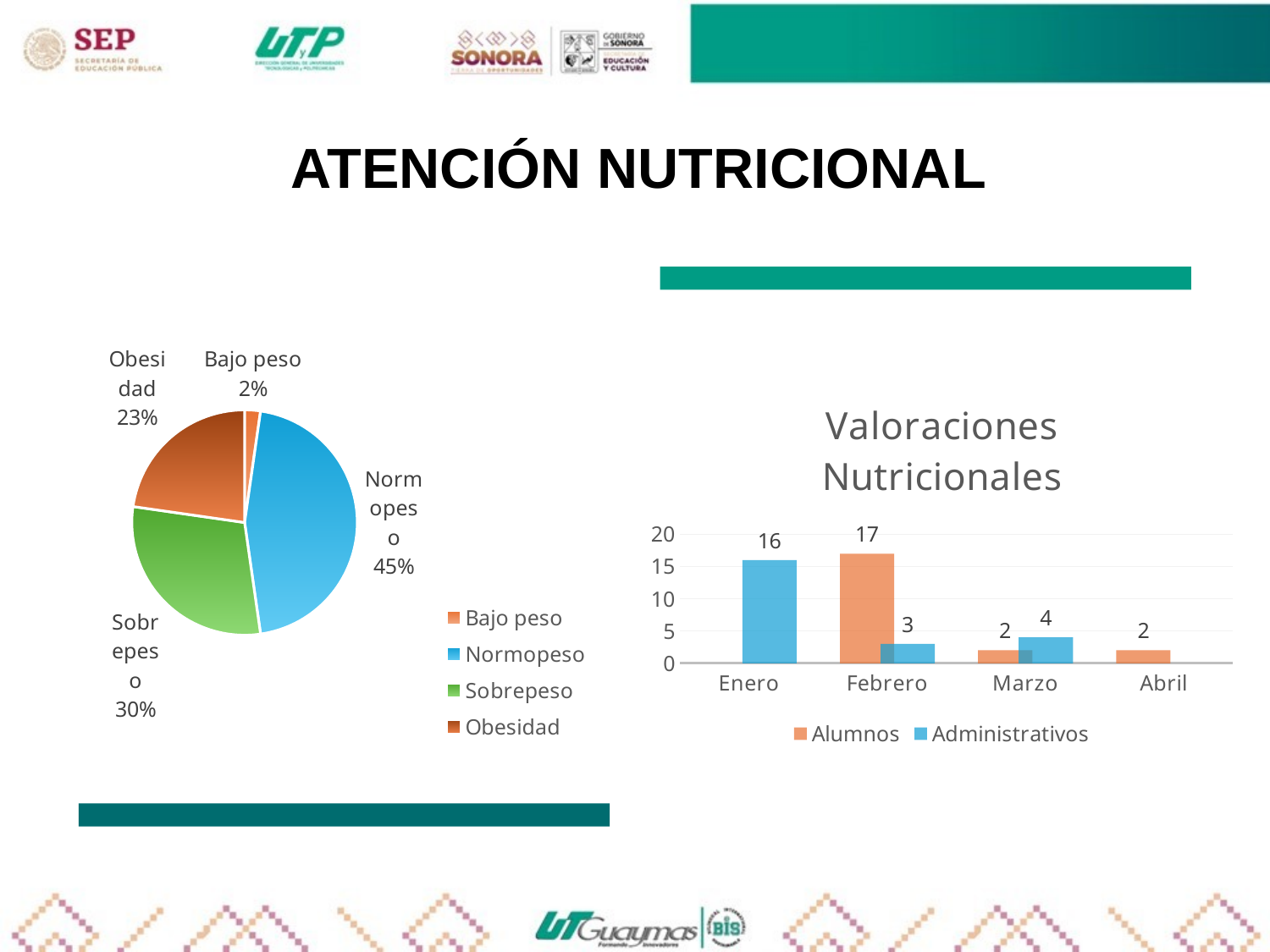
In the 'Valoraciones Nutricionales' chart, what is the value for Administrativos in Marzo? 4 In the pie chart on the left, how many categories does the legend list? 4 In the pie chart on the left, what share does Obesidad have? 23% In the 'Valoraciones Nutricionales' chart, what is the value for Alumnos in Febrero? 17 In the pie chart on the left, which category has the smallest share? Bajo peso In the 'Valoraciones Nutricionales' chart, how many series does the legend list? 2 In the pie chart on the left, what is the difference between the Sobrepeso and Obesidad shares? 7% In the pie chart on the left, which category has the largest share? Normopeso In the pie chart on the left, what share does Normopeso have? 45% In the 'Valoraciones Nutricionales' chart, what is the value for Administrativos in Enero? 16 What kind of chart is 'Valoraciones Nutricionales'? Bar chart In the 'Valoraciones Nutricionales' chart, which is larger in Febrero: Alumnos or Administrativos? Alumnos